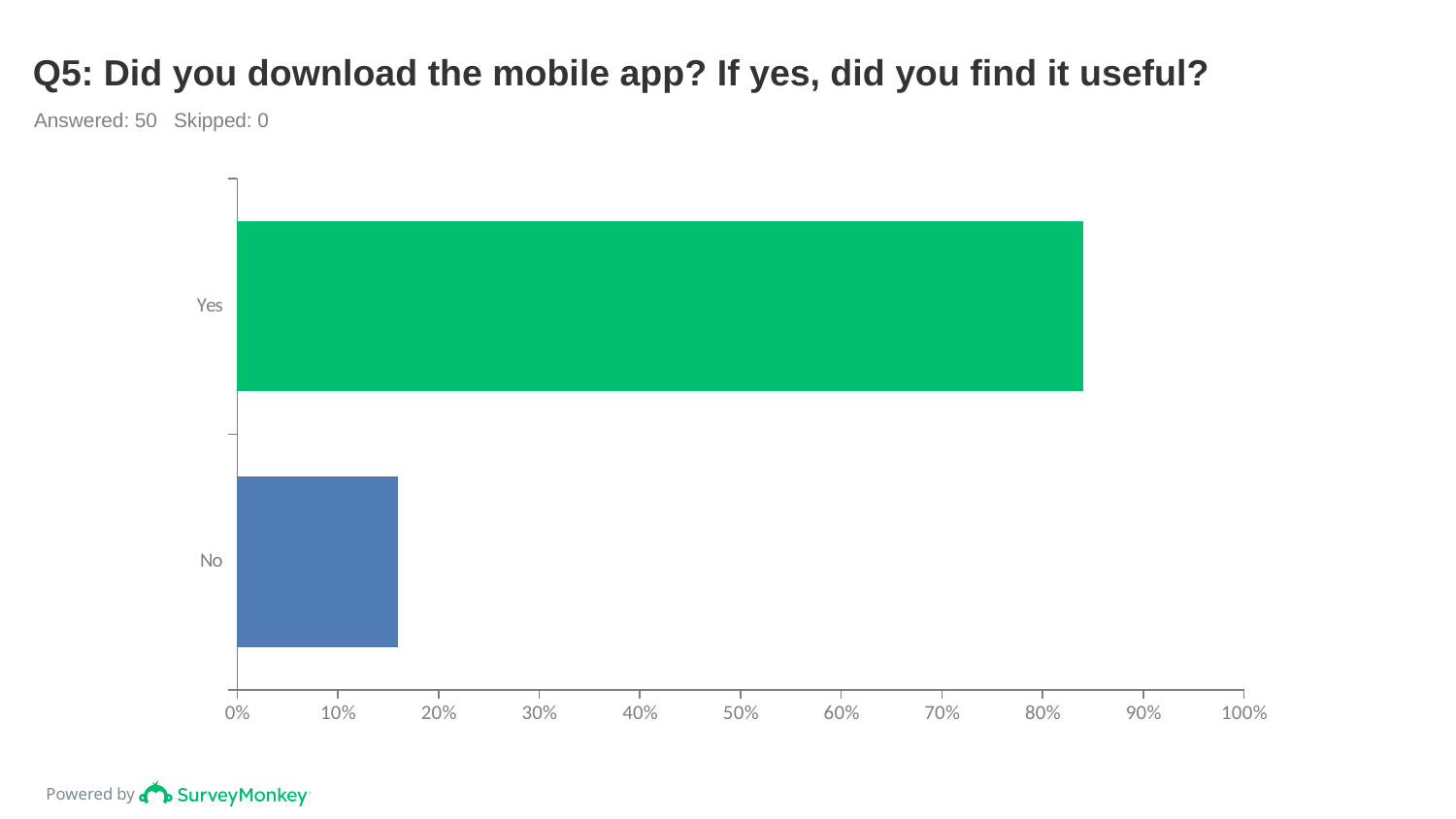
How many respondents answered the question according to the slide? 50 Which category has the highest value? Yes What is the title of the chart? Q5: Did you download the mobile app? If yes, did you find it useful? Is the value for No greater or less than 20%? less Is the value for Yes greater or less than 90%? less How many categories are plotted in the chart? 2 Is the value for Yes greater or less than 80%? greater Which is larger, the value for Yes or the value for No? Yes What kind of chart is shown on the slide? bar chart Which category has the lowest value? No